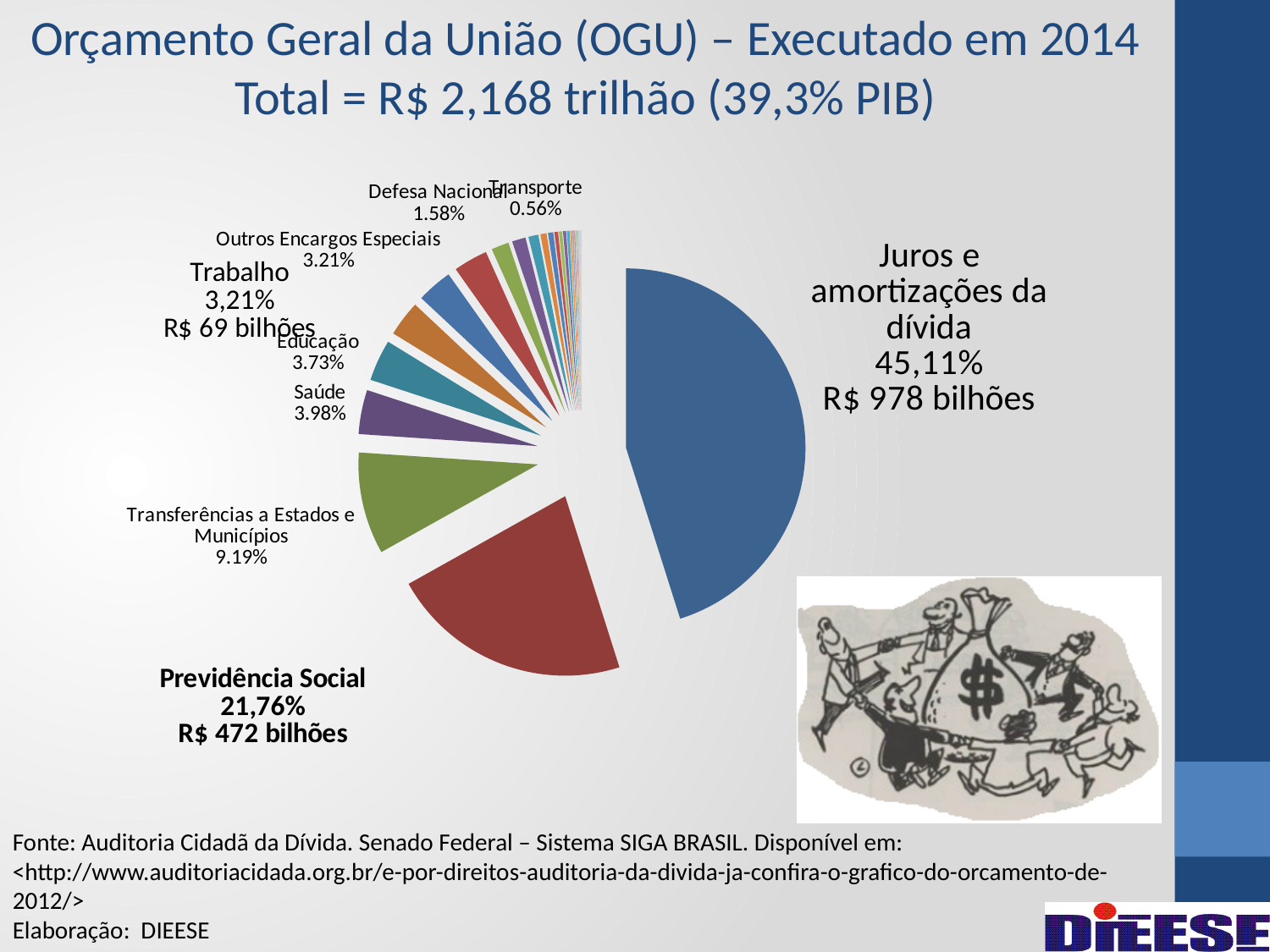
What percentage is shown for Saúde? 3.98% Which is larger, the share for Saúde or the share for Educação? Saúde What amount in reais is shown for Juros e amortizações da dívida? R$ 978 bilhões What is the difference in reais between Juros e amortizações da dívida and Previdência Social? R$ 506 bilhões Which category has the largest share of the pie? Juros e amortizações da dívida What percentage of the budget is labelled for Juros e amortizações da dívida? 45,11% What amount in reais is shown for Trabalho? R$ 69 bilhões What percentage is shown for Educação? 3.73% What amount in reais is shown for Previdência Social? R$ 472 bilhões What percentage is shown for Previdência Social? 21,76% What percentage is shown for Transferências a Estados e Municípios? 9.19% What kind of chart is shown on the slide? pie chart